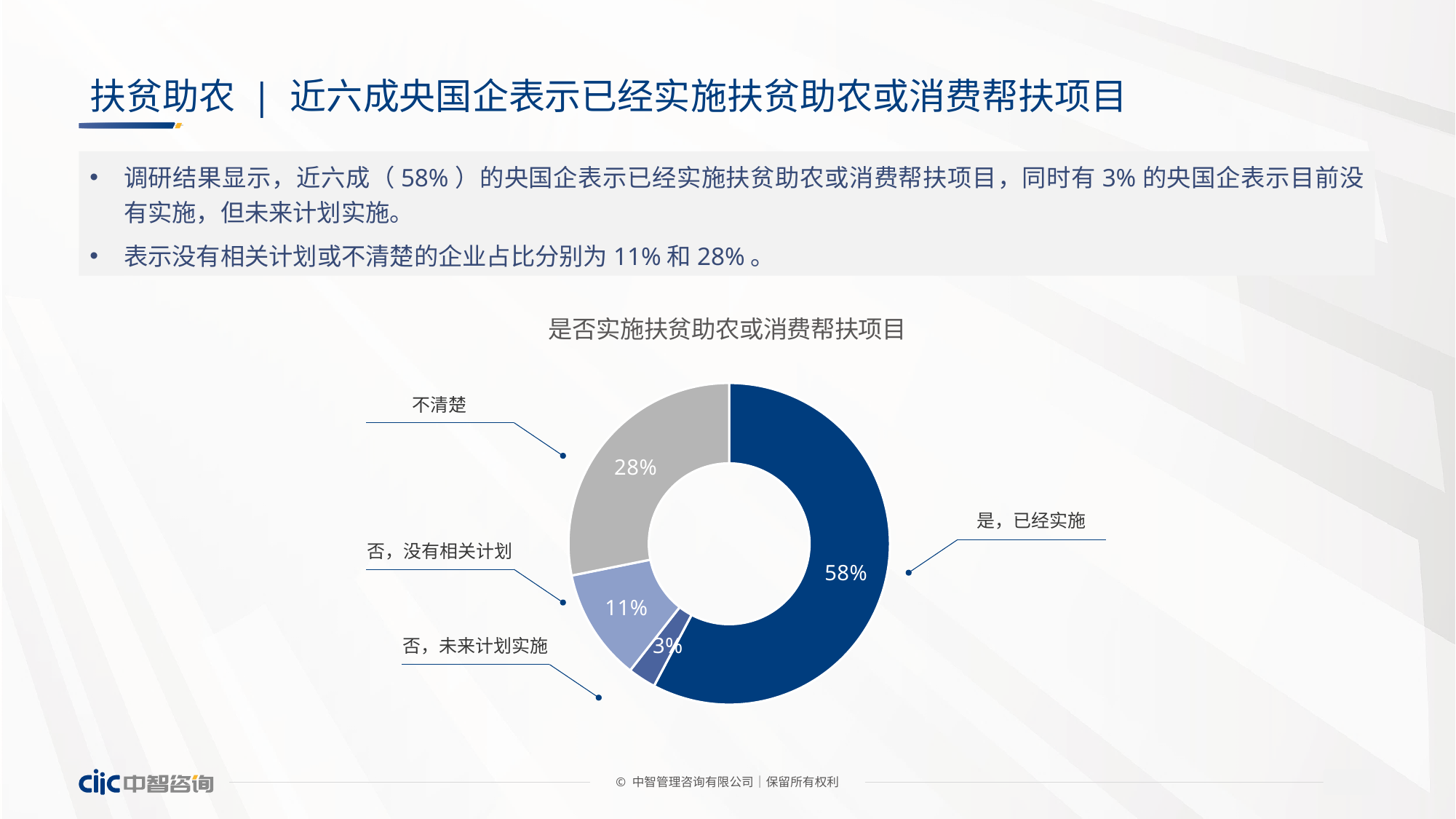
What is the difference between the shares for "是，已经实施" and "不清楚"? 30% What is the difference between the shares for "否，没有相关计划" and "否，未来计划实施"? 8% What is the value for "不清楚"? 28% What is the title of the chart? 是否实施扶贫助农或消费帮扶项目 How many categories does the pie chart show? 4 What is the value for "否，未来计划实施"? 3% Which category has the largest share of the pie? 是，已经实施 What is the value for "否，没有相关计划"? 11% Which is larger, the share for "不清楚" or the share for "否，没有相关计划"? 不清楚 What kind of chart is shown on the slide? Pie chart (doughnut) What share of the pie does "是，已经实施" represent? 58% Which category has the smallest share of the pie? 否，未来计划实施